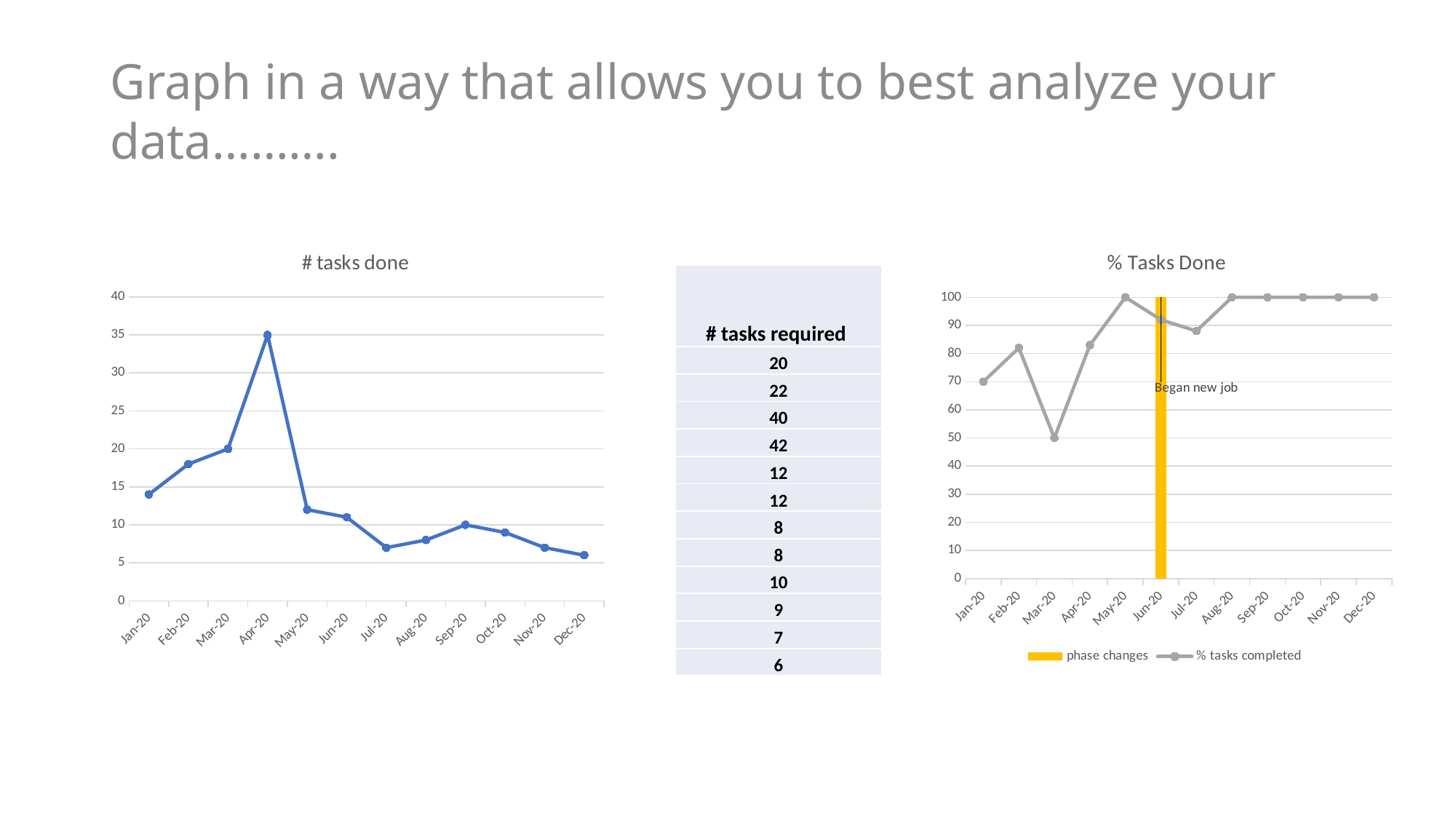
In the "% Tasks Done" chart, which month has the lowest value? Mar-20 In the "# tasks done" chart, how many months are plotted on the x axis? 12 In the "% Tasks Done" chart, what is the value for Jan-20? 70 In the "# tasks done" chart, what is the difference between the Apr-20 and Mar-20 values? 15 In the "# tasks done" chart, what is the value for Apr-20? 35 In the "% Tasks Done" chart, is the value for Jun-20 greater or less than 80? greater In the "# tasks done" chart, what is the value for Mar-20? 20 In the "# tasks done" chart, which month has the highest value? Apr-20 How many entries does the legend of the "% Tasks Done" chart list? 2 What kind of chart is the "# tasks done" chart? line chart In the "# tasks done" chart, is the value for Jan-20 greater or less than 15? less In the "# tasks done" chart, do the values rise or fall from Apr-20 to Jul-20? fall